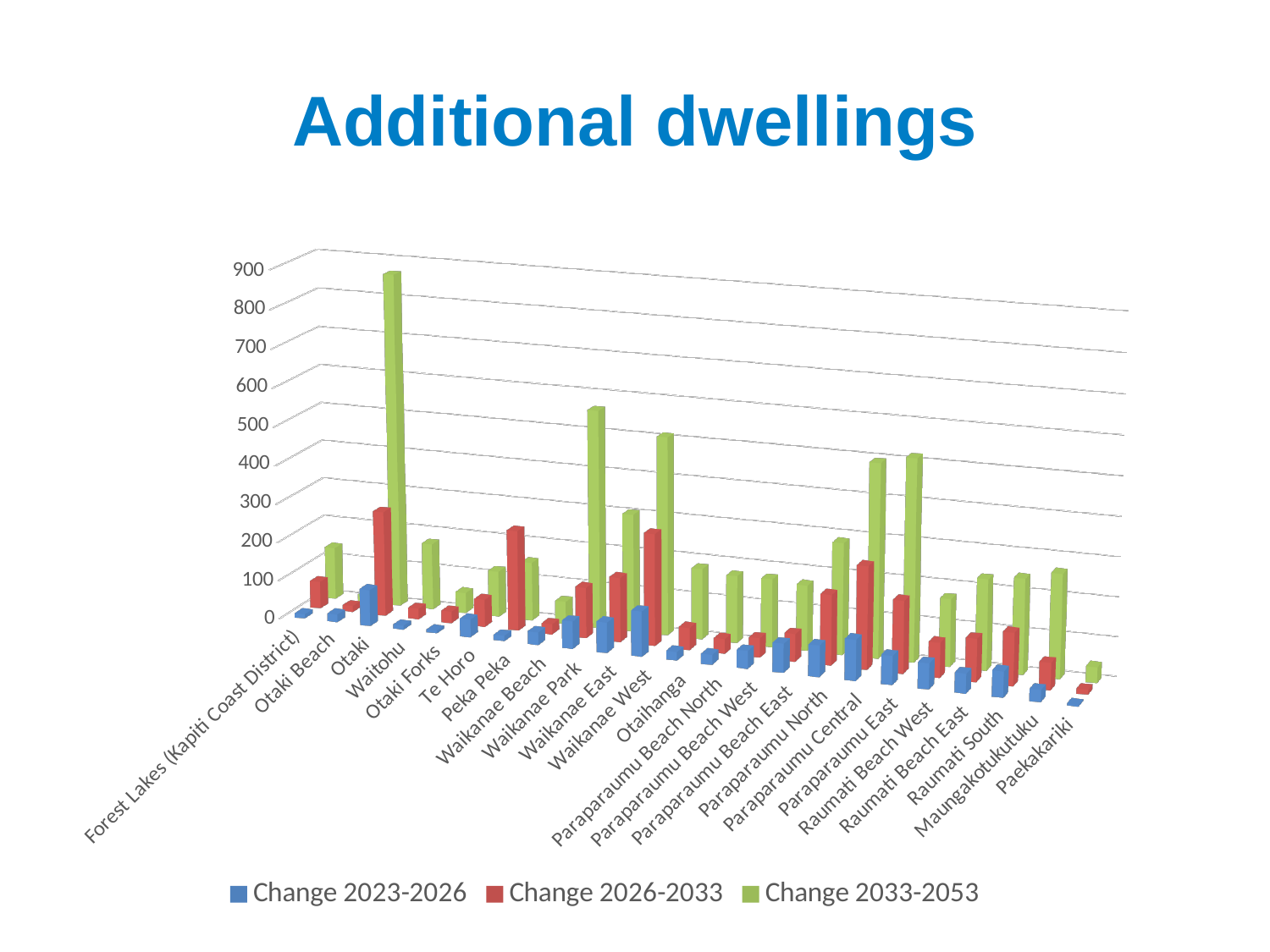
How many series does the legend list? 3 Is the value for Otaki in the Change 2033-2053 series greater or less than 700? greater What kind of chart is shown on the slide? bar chart Which category has the highest value for Change 2033-2053? Otaki Which is larger for Change 2026-2033: Otaki or Otaki Beach? Otaki Which is larger for Change 2033-2053: Otaki or Waikanae Park? Otaki Is the value for Waikanae Park in the Change 2033-2053 series greater or less than 300? greater Which category has the highest value for Change 2026-2033? Waikanae West Which series is shown in green? Change 2033-2053 What is the title of the chart? Additional dwellings Which category has the lowest value for Change 2033-2053? Otaki Beach How many categories are shown along the x axis? 23